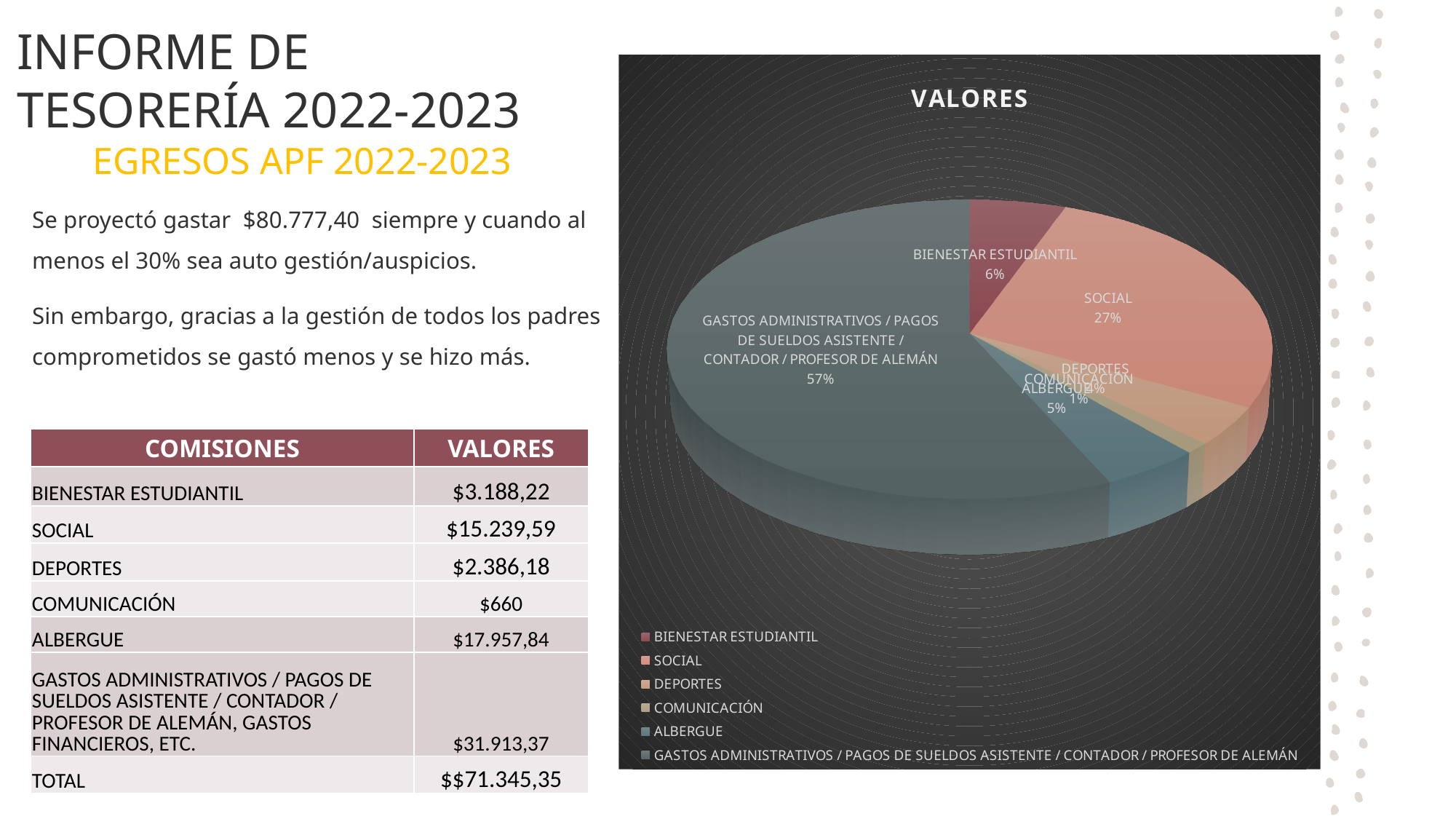
What share of the pie does SOCIAL represent? 27% How many entries does the chart legend list? 6 What share of the pie does ALBERGUE represent? 5% How many categories does the pie chart show? 6 Which slice is larger, SOCIAL or ALBERGUE? SOCIAL What share of the pie does GASTOS ADMINISTRATIVOS / PAGOS DE SUELDOS ASISTENTE / CONTADOR / PROFESOR DE ALEMÁN represent? 57% Which category has the smallest slice of the pie? COMUNICACIÓN How many percentage points larger is the GASTOS ADMINISTRATIVOS slice than the SOCIAL slice? 30 What kind of chart is shown on the slide? Pie chart What is the title of the chart? VALORES Which category has the largest slice of the pie? GASTOS ADMINISTRATIVOS / PAGOS DE SUELDOS ASISTENTE / CONTADOR / PROFESOR DE ALEMÁN